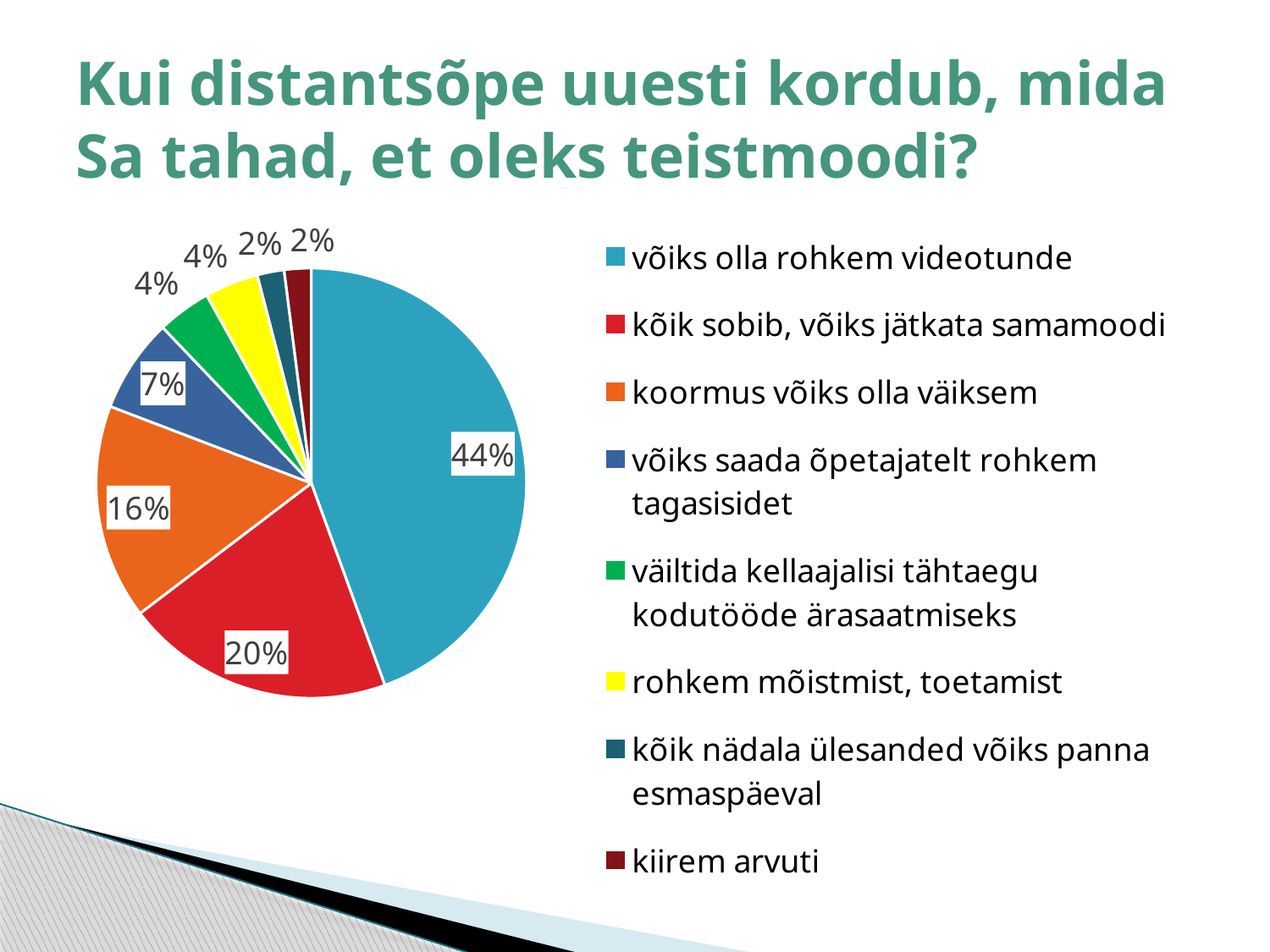
What is the difference between the shares for 'võiks olla rohkem videotunde' and 'kõik sobib, võiks jätkata samamoodi'? 24% How many slices does the pie chart have? 8 What share of the pie is 'koormus võiks olla väiksem'? 16% What share of the pie is 'võiks saada õpetajatelt rohkem tagasisidet'? 7% What kind of chart is shown on the slide? pie chart What colour is the slice for 'rohkem mõistmist, toetamist'? yellow Which is larger: the share for 'koormus võiks olla väiksem' or the share for 'võiks saada õpetajatelt rohkem tagasisidet'? koormus võiks olla väiksem Which category has the largest slice of the pie? võiks olla rohkem videotunde What share of the pie is 'võiks olla rohkem videotunde'? 44% What is the title of the slide containing the pie chart? Kui distantsõpe uuesti kordub, mida Sa tahad, et oleks teistmoodi? What share of the pie is 'kõik sobib, võiks jätkata samamoodi'? 20% What share of the pie is 'kiirem arvuti'? 2%